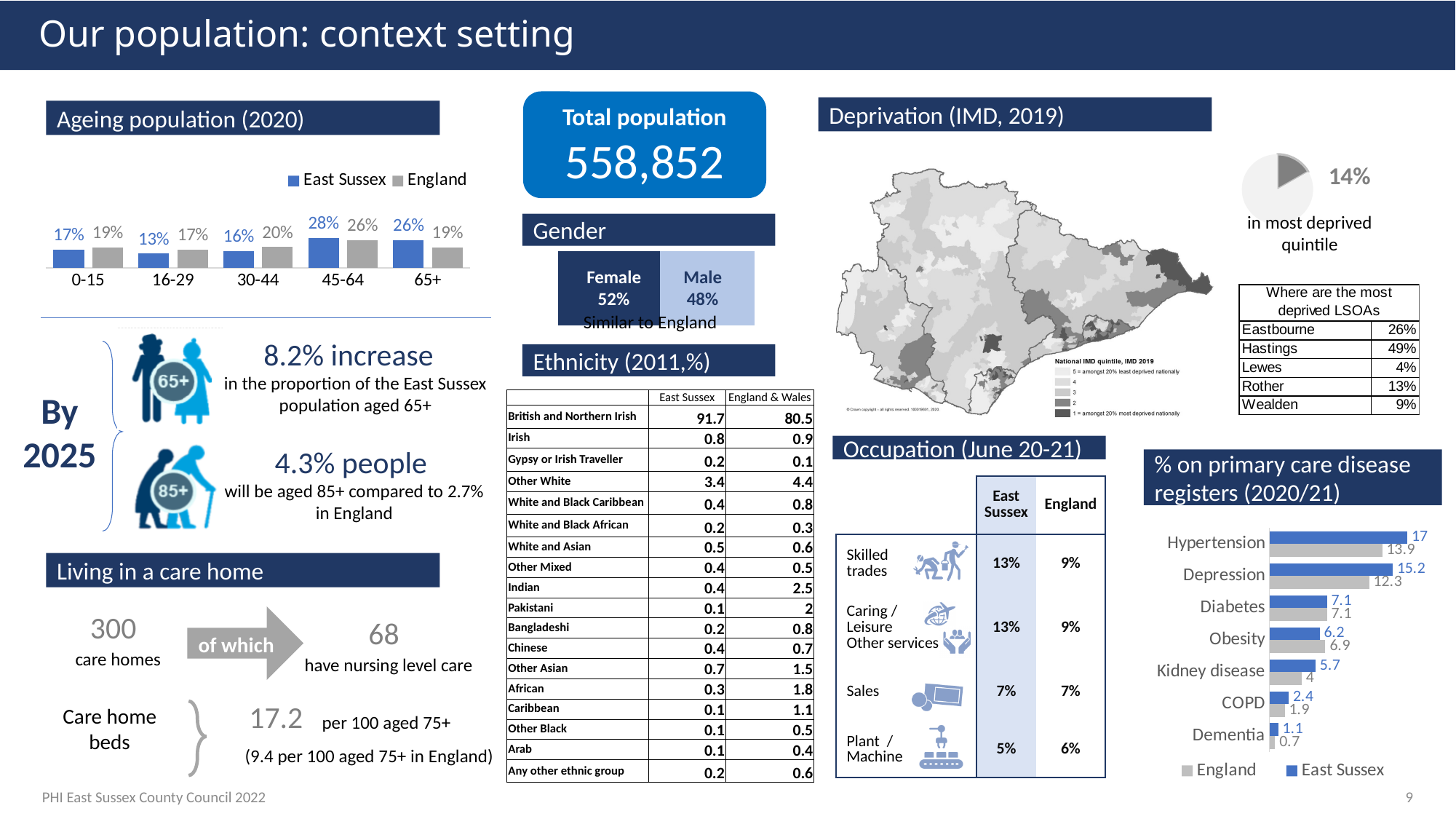
In the Deprivation (IMD, 2019) pie chart, what share of the population is in the most deprived quintile? 14% In the Ageing population (2020) chart, what is the England value for the 30-44 age group? 20% In the Ageing population (2020) chart, how many series does the legend list? 2 In the Ageing population (2020) chart, which age group has the highest East Sussex value? 45-64 In the Ageing population (2020) chart, what is the East Sussex value for the 45-64 age group? 28% In the Ageing population (2020) chart, what is the difference between the East Sussex and England values for the 65+ age group? 7% In the % on primary care disease registers (2020/21) chart, what is the England value for Kidney disease? 4 In the % on primary care disease registers (2020/21) chart, is the East Sussex value for Obesity larger or smaller than the England value? smaller In the % on primary care disease registers (2020/21) chart, which condition has the highest East Sussex value? Hypertension In the % on primary care disease registers (2020/21) chart, what is the East Sussex value for Depression? 15.2 In the Ageing population (2020) chart, which age group has the lowest East Sussex value? 16-29 In the Ageing population (2020) chart, how many age groups are shown? 5